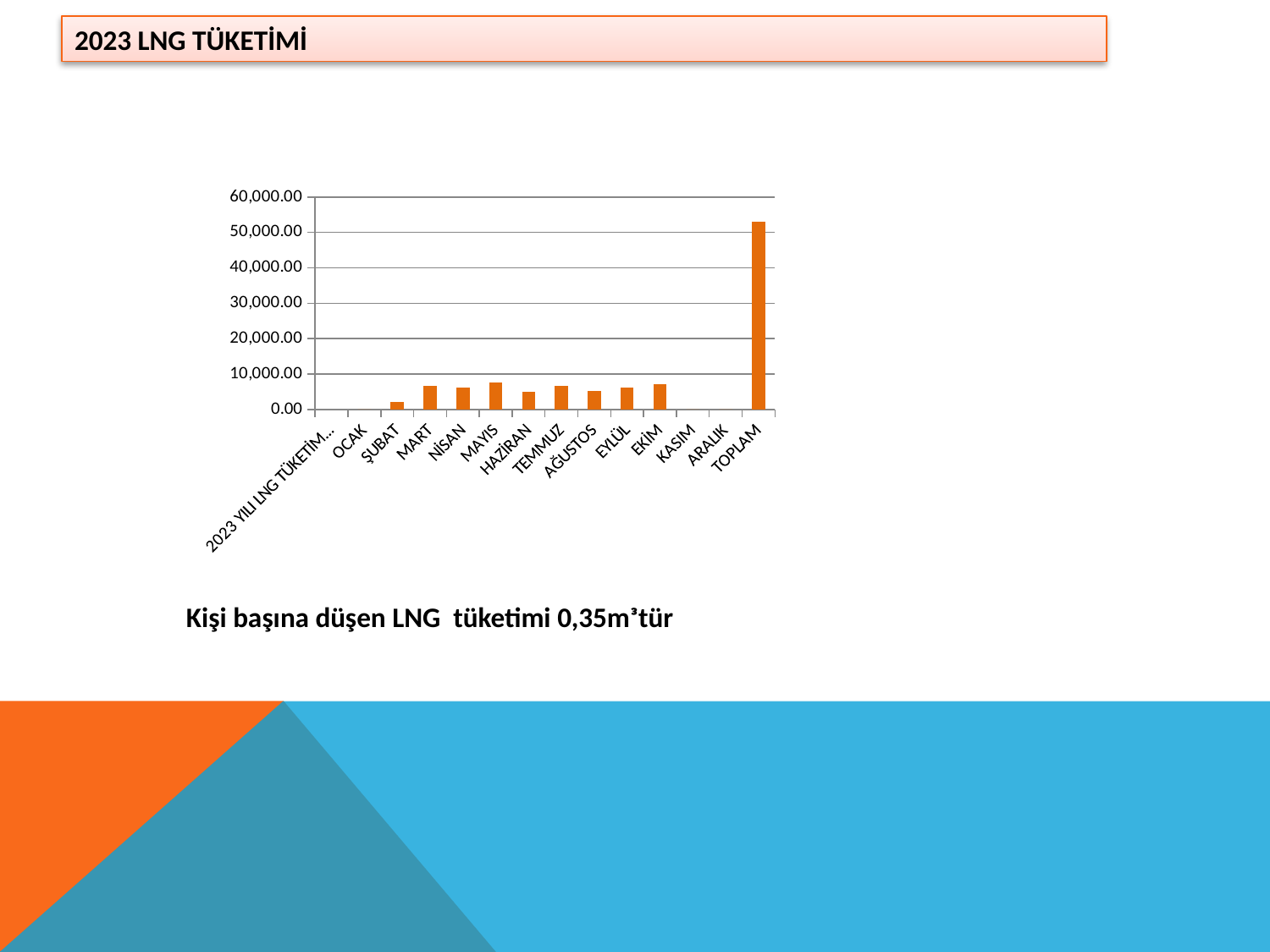
How many categories are shown on the x axis of the chart? 14 Which category has the highest bar in the chart? TOPLAM Is the value for TOPLAM greater or less than 50,000.00? greater Is the value for ŞUBAT greater or less than 10,000.00? less What colour are the bars in the chart? Orange Which is larger, the value for MAYIS or the value for HAZİRAN? MAYIS Is the value for MAYIS greater or less than 10,000.00? less What is the highest value shown on the y axis of the chart? 60,000.00 Which is larger, the value for TOPLAM or the value for EKİM? TOPLAM Which is larger, the value for ŞUBAT or the value for MART? MART What kind of chart is shown on the slide? Bar chart